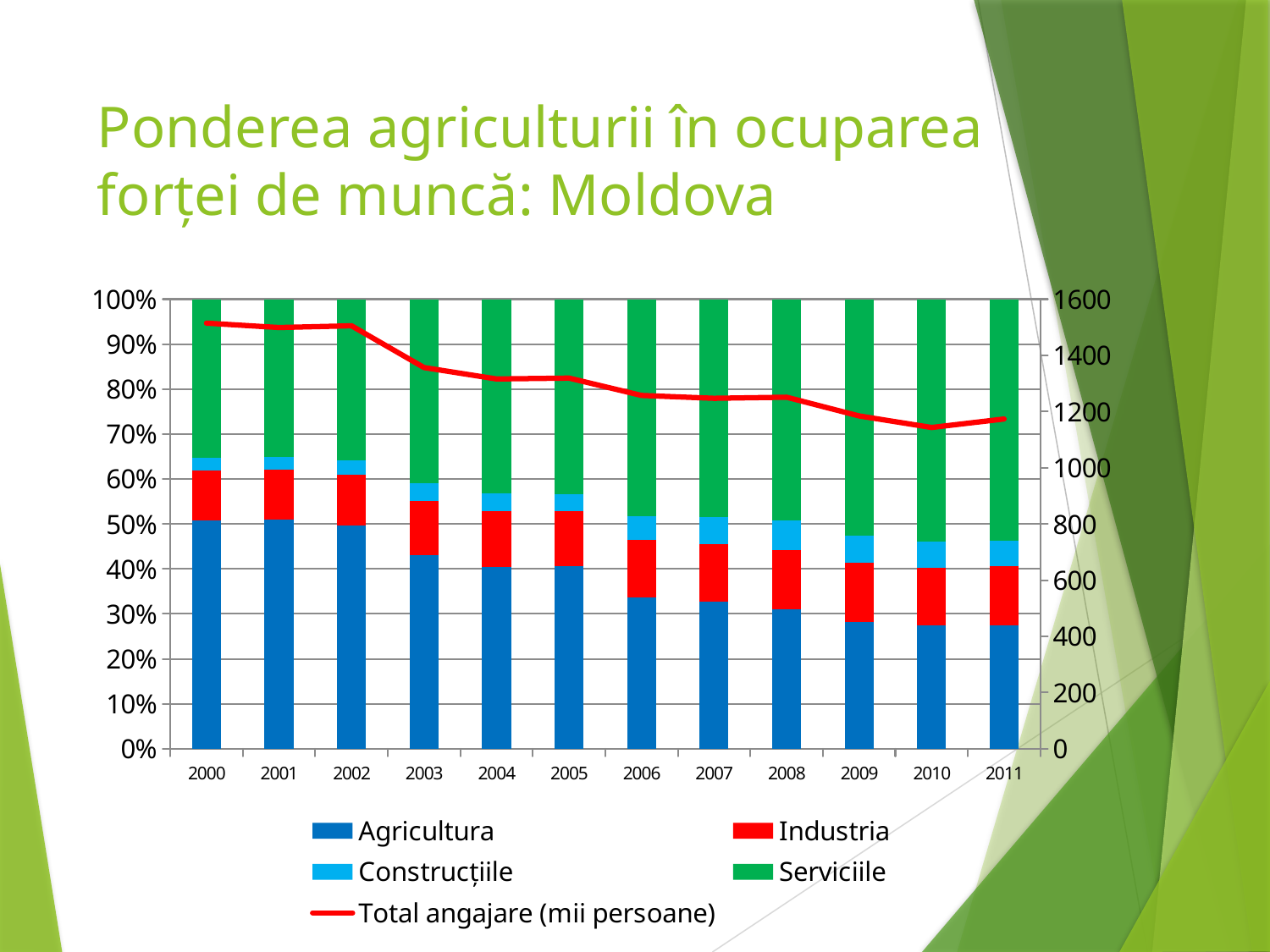
Is the Total angajare (mii persoane) value for 2010 greater or less than 1200? less Is the Agricultura share for 2011 greater or less than 30%? less Is the Agricultura share for 2003 greater or less than 40%? greater Which year has the lowest Total angajare (mii persoane) value? 2010 Does the Agricultura share rise or fall from 2000 to 2011? fall How many years are shown on the x axis of the chart? 12 What kind of chart is shown on the slide? stacked bar chart with a line What is the highest value shown on the right-hand axis of the chart? 1600 Which year has the larger Serviciile share, 2000 or 2011? 2011 How many series does the chart legend list? 5